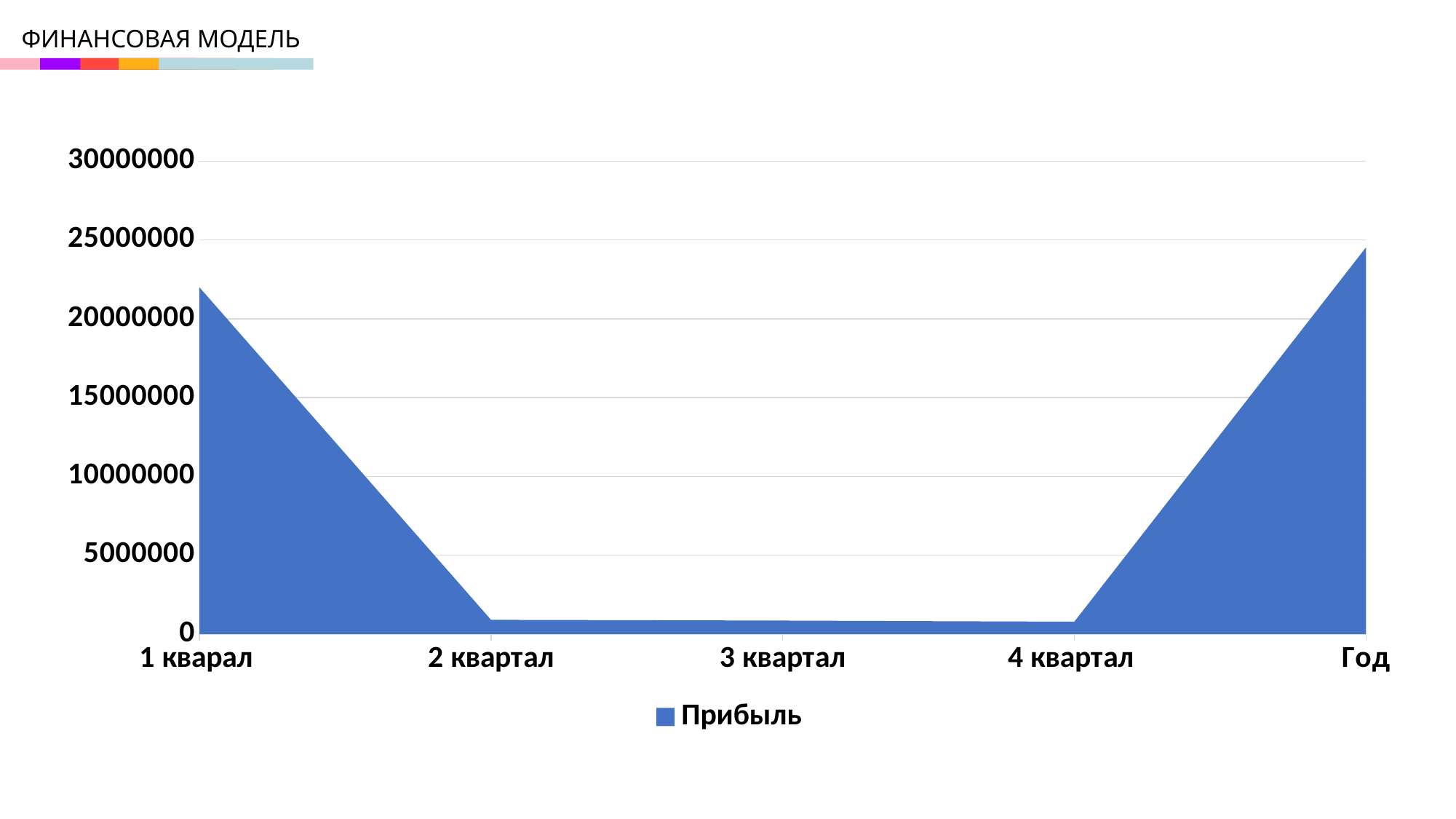
Is the value for 1 кварал greater or less than 20000000? greater Which is larger, the value for 1 кварал or the value for 2 квартал? 1 кварал What is the name of the series shown in the chart legend? Прибыль How many categories are shown on the x axis of the chart? 5 Does the value rise or fall from 1 кварал to 2 квартал? Fall Is the value for Год greater or less than 25000000? less Is the value for 3 квартал greater or less than 5000000? less Which category has the highest value for Прибыль? Год Which is larger, the value for Год or the value for 4 квартал? Год What kind of chart is shown on the slide? Area chart How many series does the chart legend list? 1 What is the title text at the top of the slide? ФИНАНСОВАЯ МОДЕЛЬ